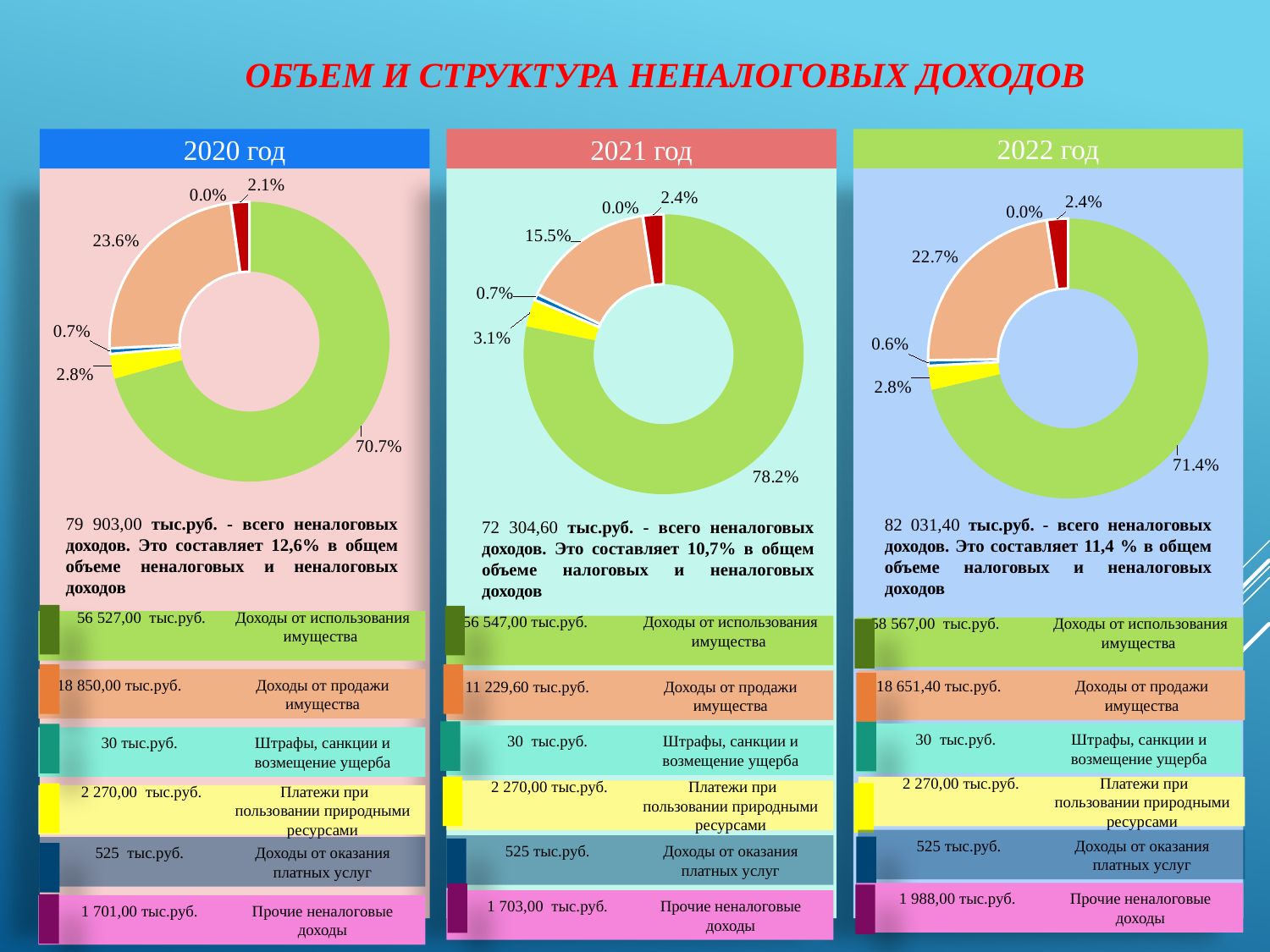
In the 2022 год chart, what share is shown for the orange slice (Доходы от продажи имущества)? 22.7% What type of chart is used for each year on this slide? Donut (pie) chart In the 2020 год chart, which category has the smallest share? Штрафы, санкции и возмещение ущерба How many slices are labelled in the 2022 год chart? 6 In the 2021 год chart, what share is shown for the red slice (Прочие неналоговые доходы)? 2.4% In the 2020 год chart, what share is shown for the largest slice? 70.7% In the 2021 год chart, what share is shown for the largest slice? 78.2% In the 2022 год chart, which category has the largest share? Доходы от использования имущества In the 2021 год chart, what is the difference between the largest slice (78.2%) and the orange slice (15.5%)? 62.7% In the 2020 год chart, what share is shown for the yellow slice (Платежи при пользовании природными ресурсами)? 2.8% What is the title of the slide? ОБЪЕМ И СТРУКТУРА НЕНАЛОГОВЫХ ДОХОДОВ Which is larger: the share of Доходы от продажи имущества in the 2020 год chart or in the 2021 год chart? 2020 год